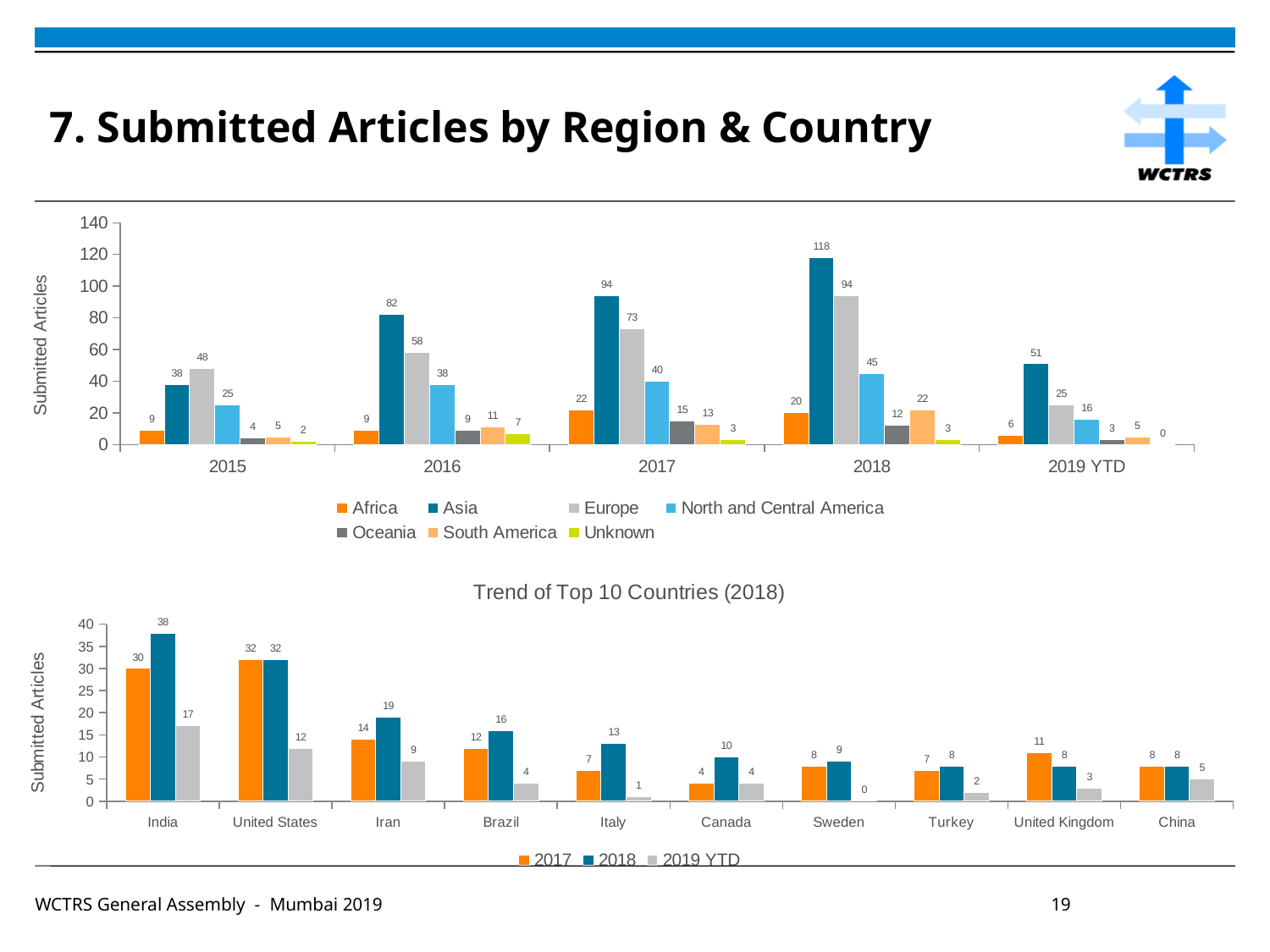
In the chart titled 'Trend of Top 10 Countries (2018)', what is the 2018 value for India? 38 In the top chart, which region has the highest value in 2017? Asia In the chart titled 'Trend of Top 10 Countries (2018)', which country has the highest 2017 value? United States In the top chart, what is the difference between Asia and Europe in 2018? 24 In the chart titled 'Trend of Top 10 Countries (2018)', which is larger for Iran: the 2017 value or the 2018 value? 2018 In the top chart, how does the value for Asia change from 2015 to 2018? It rises In the chart titled 'Trend of Top 10 Countries (2018)', what is the difference between the 2018 and 2019 YTD values for Brazil? 12 In the chart titled 'Trend of Top 10 Countries (2018)', how many countries are shown on the x axis? 10 What kind of chart is the bottom chart on the slide? Bar chart In the top chart, how many series does the legend list? 7 In the top chart, what is the value for Asia in 2018? 118 In the top chart, what is the value for Europe in 2016? 58